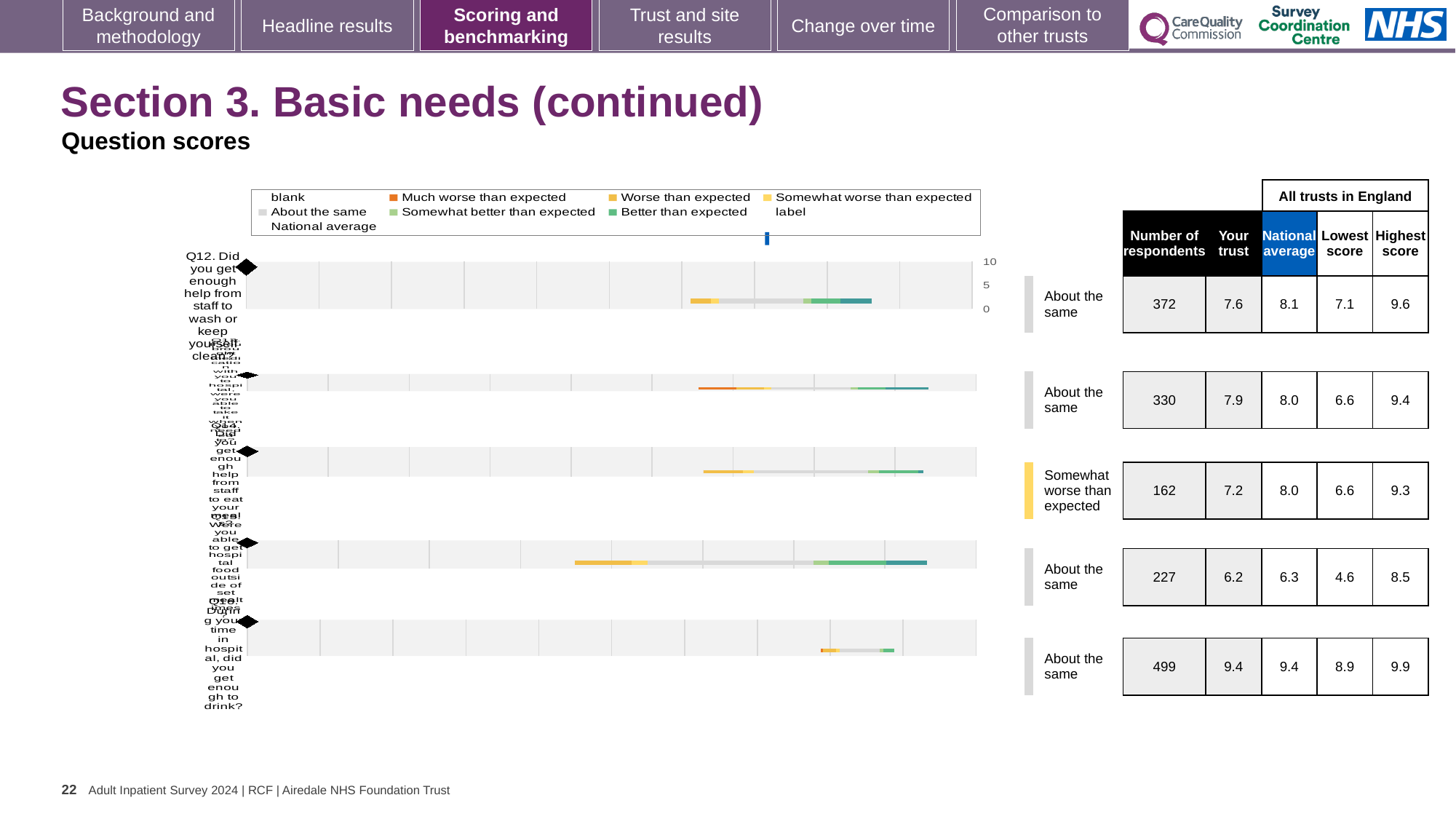
How many respondents answered Q12? 372 Which row of the chart has the highest 'Your trust' score, and what is it? The bottom row, 9.4 What benchmark category is given for the third question row? Somewhat worse than expected What colour does the legend use for 'Much worse than expected'? Orange For Q12, what is the National average score? 8.1 How many question rows are plotted in the chart? 5 For Q12 (Did you get enough help from staff to wash or keep yourself clean?), what is the 'Your trust' score? 7.6 What is the lowest 'Your trust' score shown in the table? 6.2 For Q12, which is larger: the 'Your trust' score or the National average? National average What kind of chart is used to show the question scores on this slide? bar chart For Q12, what is the difference between the National average and the 'Your trust' score? 0.5 For Q12, what is the Highest score among all trusts in England? 9.6